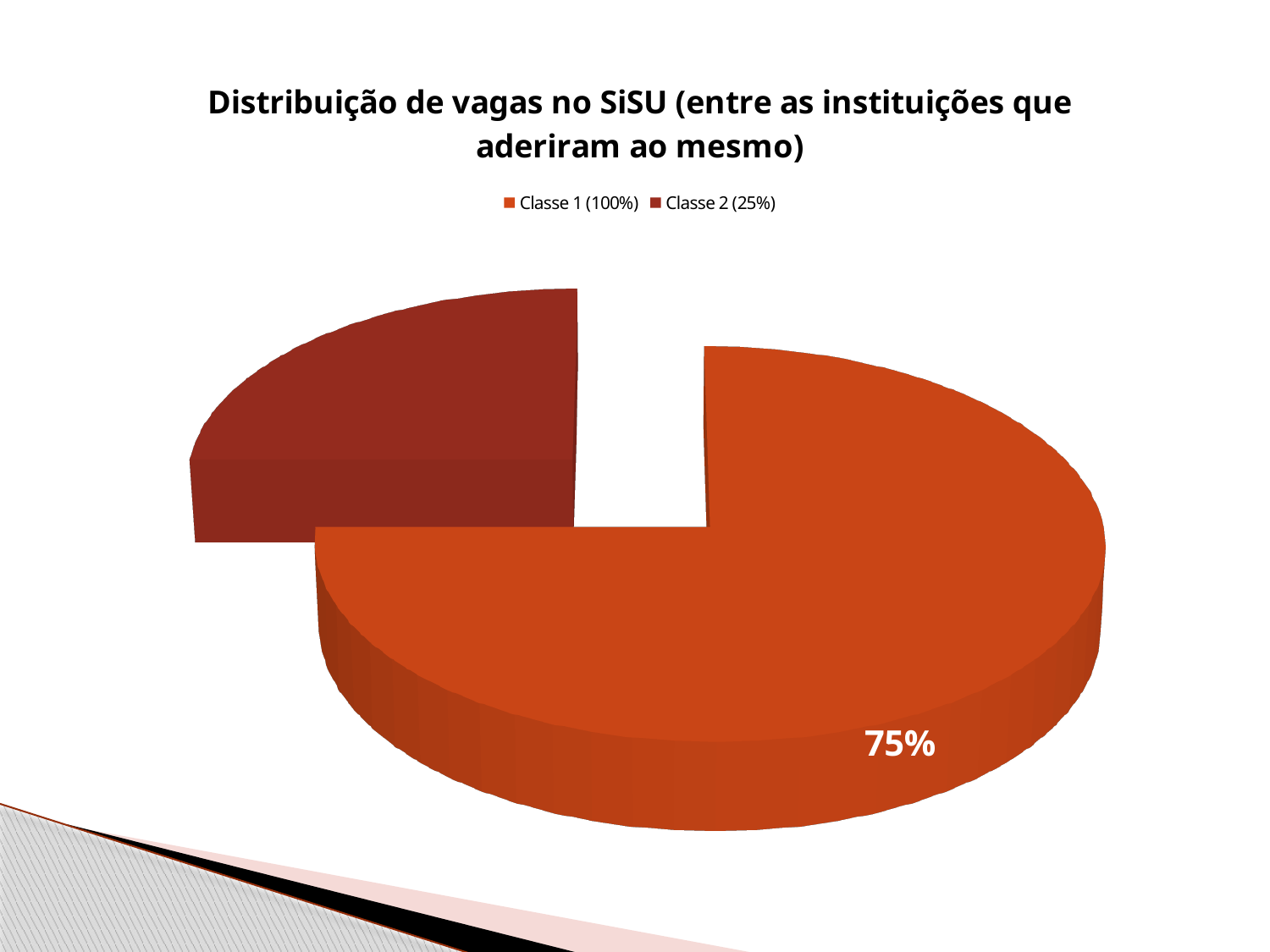
How many slices does the pie chart have? 2 What are the two legend entries of the chart? Classe 1 (100%) and Classe 2 (25%) What is the title of the chart? Distribuição de vagas no SiSU (entre as instituições que aderiram ao mesmo) What kind of chart is shown on the slide? Pie chart How many entries does the legend list? 2 Which slice is the smallest in the pie chart? Classe 2 (25%) Which slice is the largest in the pie chart? Classe 1 (100%) Which slice is larger, Classe 1 (100%) or Classe 2 (25%)? Classe 1 (100%) What percentage is labelled on the Classe 1 (100%) slice? 75%